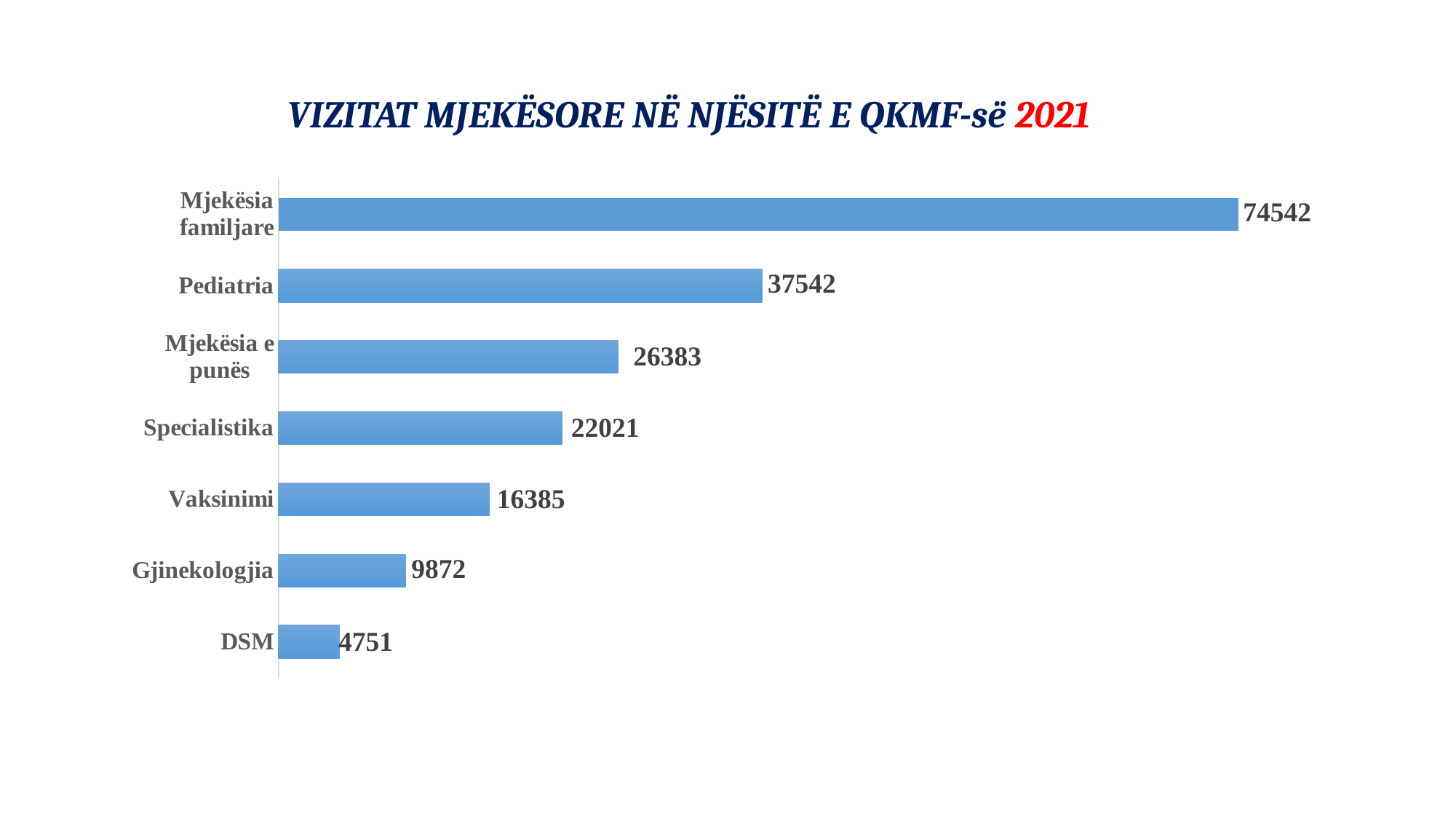
What is the value for Vaksinimi? 16385 What is the difference between the values for Mjekësia familjare and Pediatria? 37000 What is the value for Pediatria? 37542 What year is shown in the chart title? 2021 What is the value for DSM? 4751 What kind of chart is shown on the slide? Bar chart What is the value for Mjekësia familjare? 74542 What is the difference between the values for Specialistika and Gjinekologjia? 12149 Which category has the lowest value? DSM How many categories are shown in the chart? 7 Which is larger, the value for Mjekësia e punës or the value for Specialistika? Mjekësia e punës Which category has the highest value? Mjekësia familjare